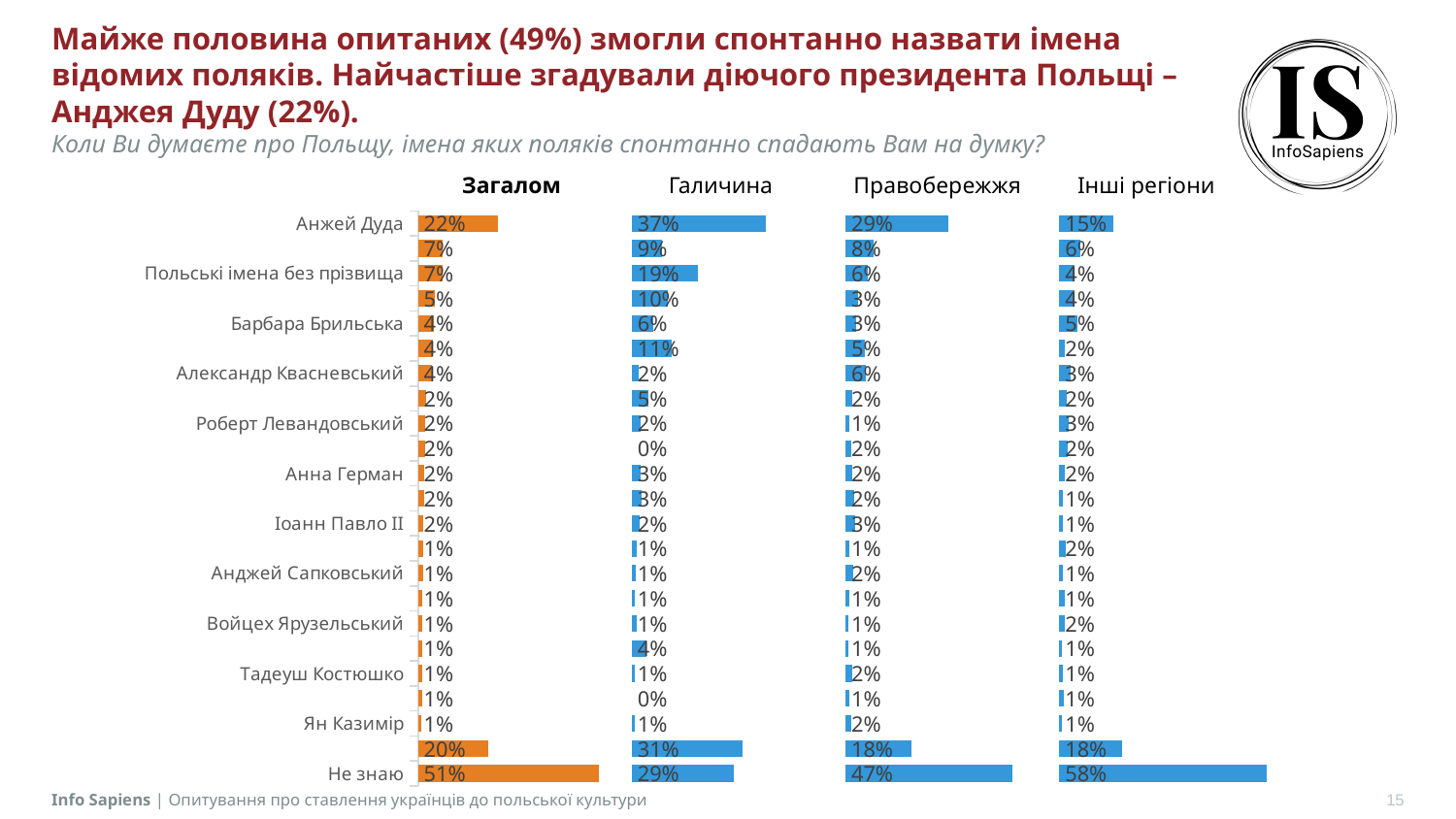
In the Правобережжя chart, which is larger: Анжей Дуда or Польські імена без прізвища? Анжей Дуда What kind of chart is used on this slide? Bar chart In the Загалом chart, what is the value for Анжей Дуда? 22% In the Галичина chart, what is the value for Польські імена без прізвища? 19% In the Галичина chart, which is larger: Анжей Дуда or Не знаю? Анжей Дуда What is the difference between the Анжей Дуда values in the Галичина chart and the Інші регіони chart? 22% In the Галичина chart, what is the value for Анжей Дуда? 37% In the Загалом chart, which labelled category has the highest value? Не знаю In the Інші регіони chart, what is the value for Не знаю? 58% What is the difference between the Не знаю values in the Інші регіони chart and the Галичина chart? 29% How many separate charts (regional columns) are shown on the slide? 4 In the Правобережжя chart, what is the value for Александр Квасневський? 6%